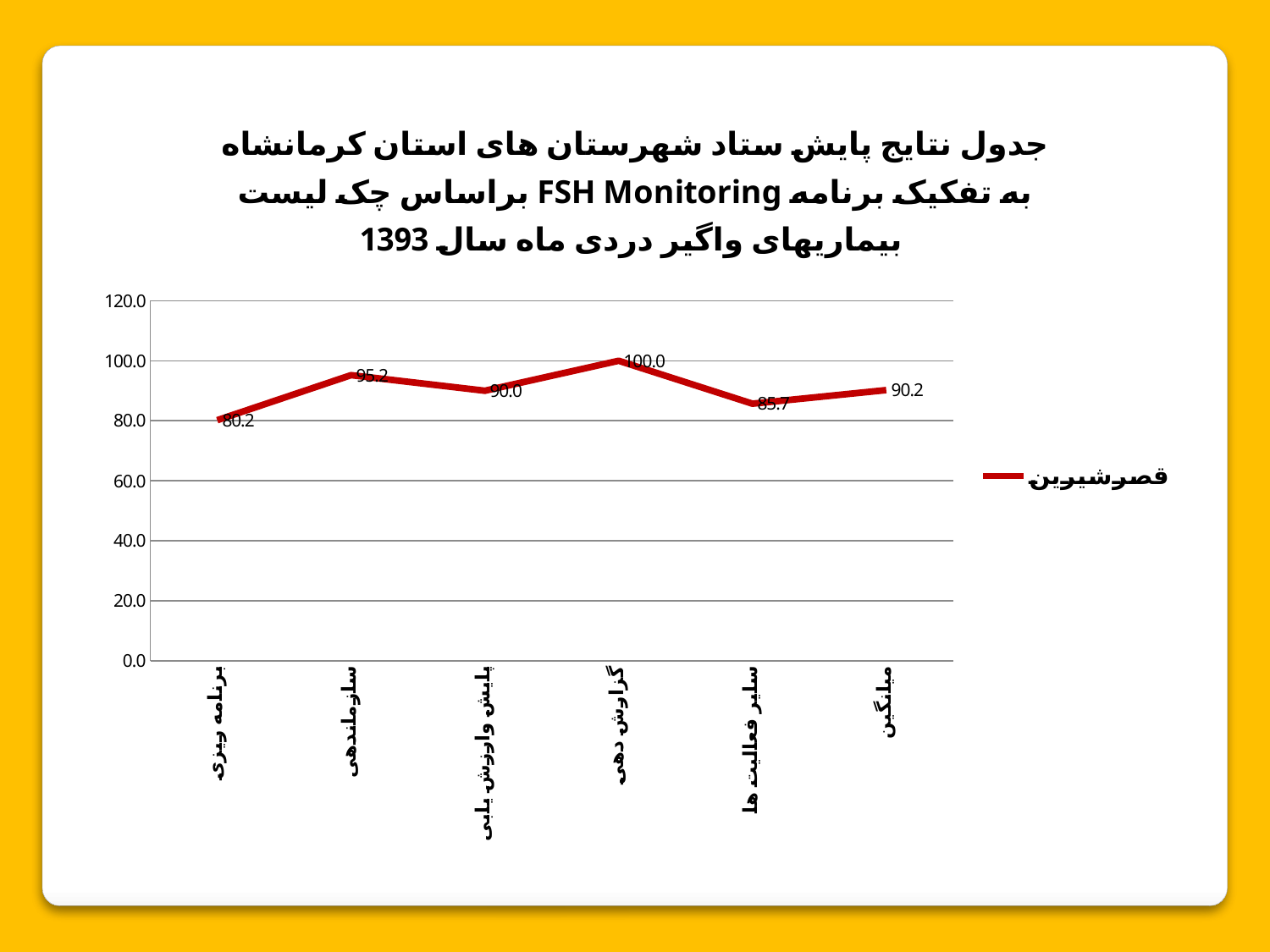
How many categories are plotted on the x axis? 6 What is the value for سایر فعالیت ها? 85.7 What is the value for برنامه ریزی? 80.2 What is the value for میانگین? 90.2 Which is larger, the value for سازماندهی or the value for سایر فعالیت ها? سازماندهی Which category has the highest value? گزارش دهی What kind of chart is shown on the slide? line chart What series name does the legend show? قصرشیرین What is the difference between the values for سازماندهی and پایش و ارزش یابی? 5.2 Is the value for برنامه ریزی greater or less than 100.0? less What is the value for گزارش دهی? 100.0 Which category has the lowest value? برنامه ریزی